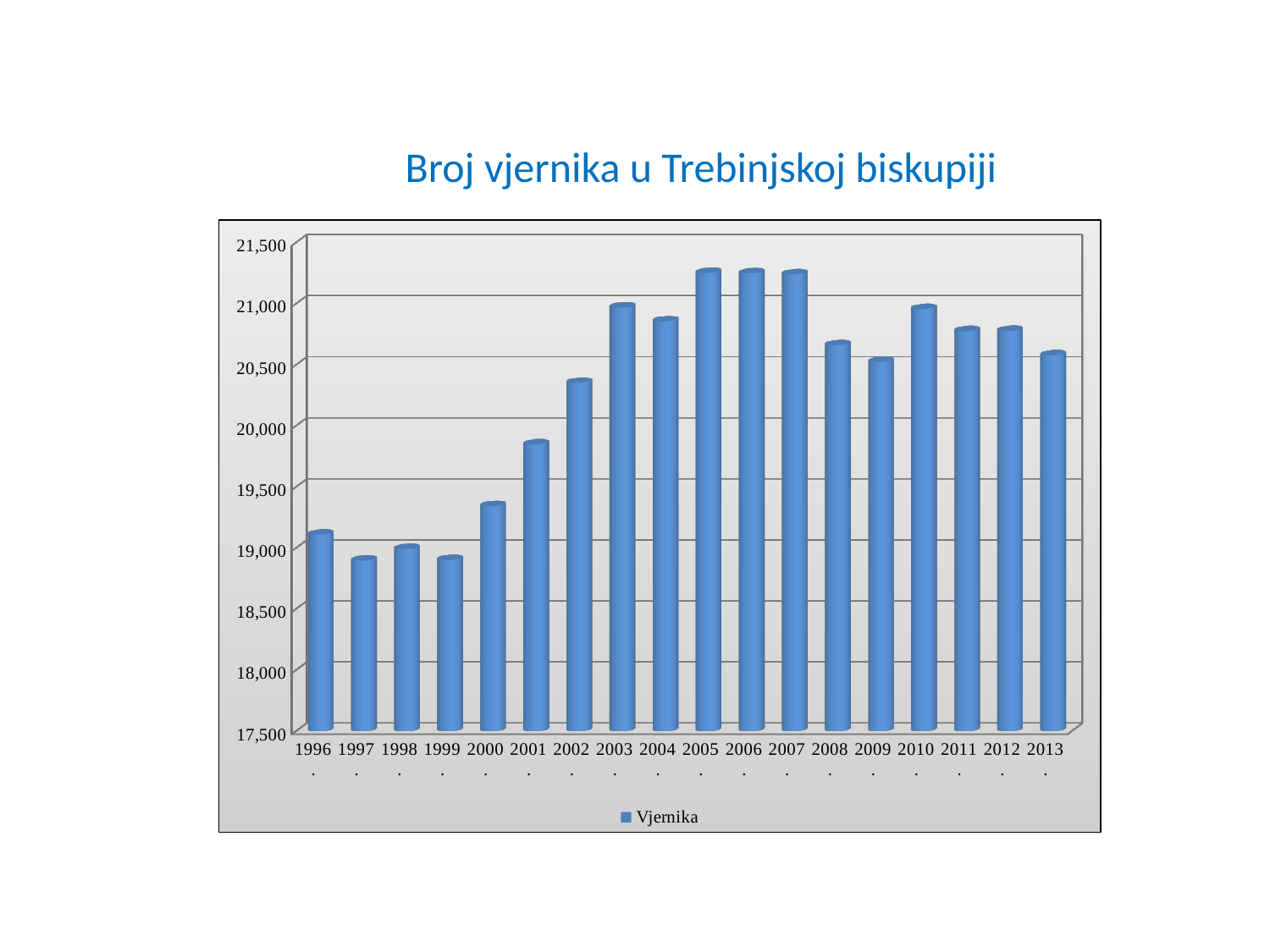
What is the name of the series shown in the legend? Vjernika Do the values rise or fall from 1999 to 2005? rise Is the value for 2005 greater or less than 21,000? greater What is the title of the chart? Broj vjernika u Trebinjskoj biskupiji Is the value for 2001 greater or less than 20,000? less How many years are plotted on the x axis of the chart? 18 Is the value for 2004 greater or less than 20,500? greater What kind of chart is shown on the slide? bar chart Which year has the larger value, 2002 or 2003? 2003 How many series does the legend list? 1